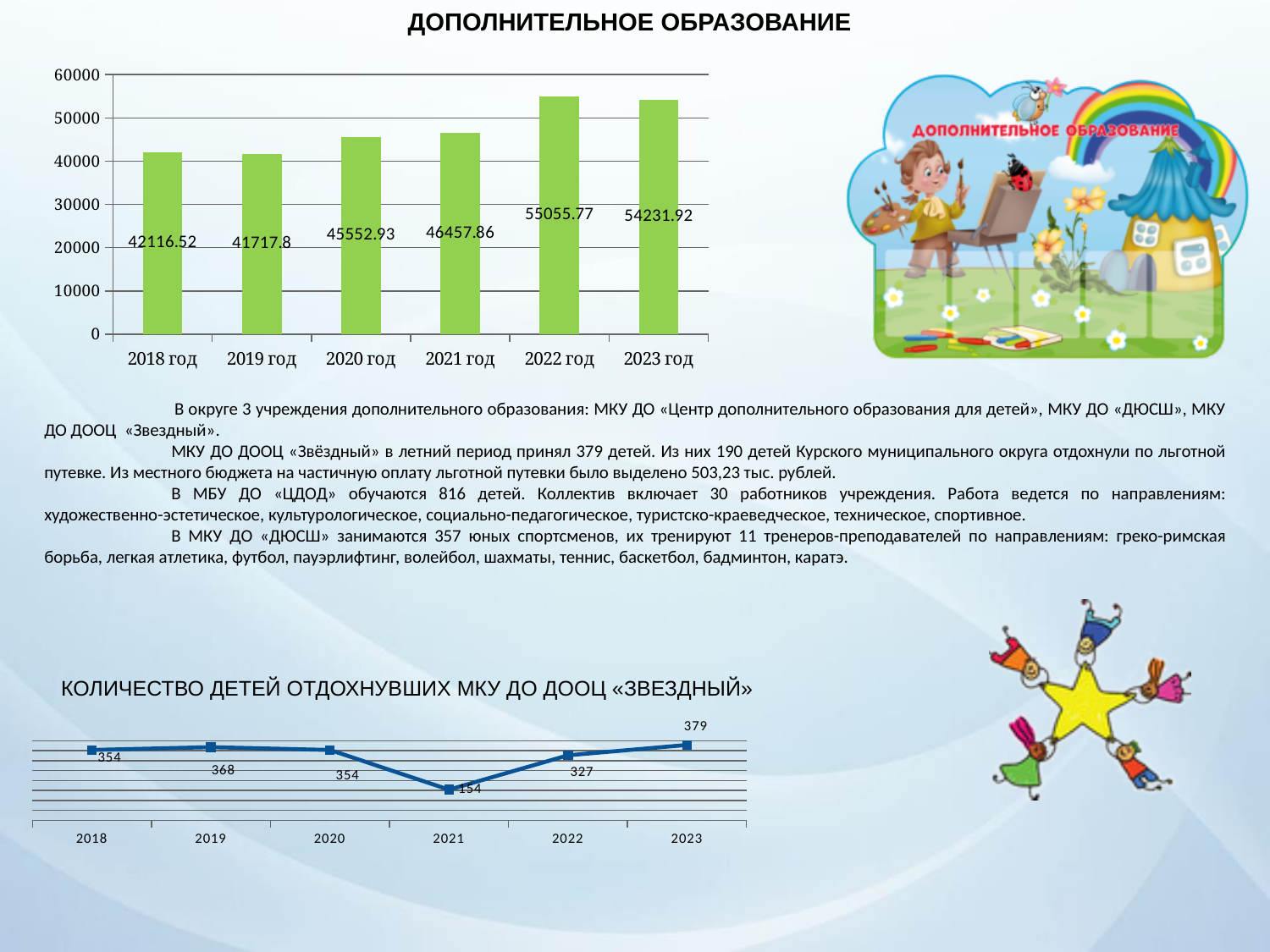
In the top bar chart, what is the value for 2019 год? 41717.8 In the top bar chart, how many years are shown on the x axis? 6 What type of chart is the top chart on the slide? Bar chart In the bottom line chart «КОЛИЧЕСТВО ДЕТЕЙ ОТДОХНУВШИХ МКУ ДО ДООЦ «ЗВЕЗДНЫЙ»», is the value for 2019 larger or smaller than the value for 2022? Larger In the top bar chart, which year has the highest value? 2022 год In the bottom line chart «КОЛИЧЕСТВО ДЕТЕЙ ОТДОХНУВШИХ МКУ ДО ДООЦ «ЗВЕЗДНЫЙ»», which year has the highest value? 2023 In the top bar chart, what is the value for 2022 год? 55055.77 In the bottom line chart «КОЛИЧЕСТВО ДЕТЕЙ ОТДОХНУВШИХ МКУ ДО ДООЦ «ЗВЕЗДНЫЙ»», what is the difference between the values for 2023 and 2022? 52 In the bottom line chart «КОЛИЧЕСТВО ДЕТЕЙ ОТДОХНУВШИХ МКУ ДО ДООЦ «ЗВЕЗДНЫЙ»», what is the value for 2021? 154 In the top bar chart, which year has the lowest value? 2019 год In the top bar chart, what is the difference between the values for 2021 год and 2020 год? 904.93 In the bottom line chart «КОЛИЧЕСТВО ДЕТЕЙ ОТДОХНУВШИХ МКУ ДО ДООЦ «ЗВЕЗДНЫЙ»», which year has the lowest value? 2021